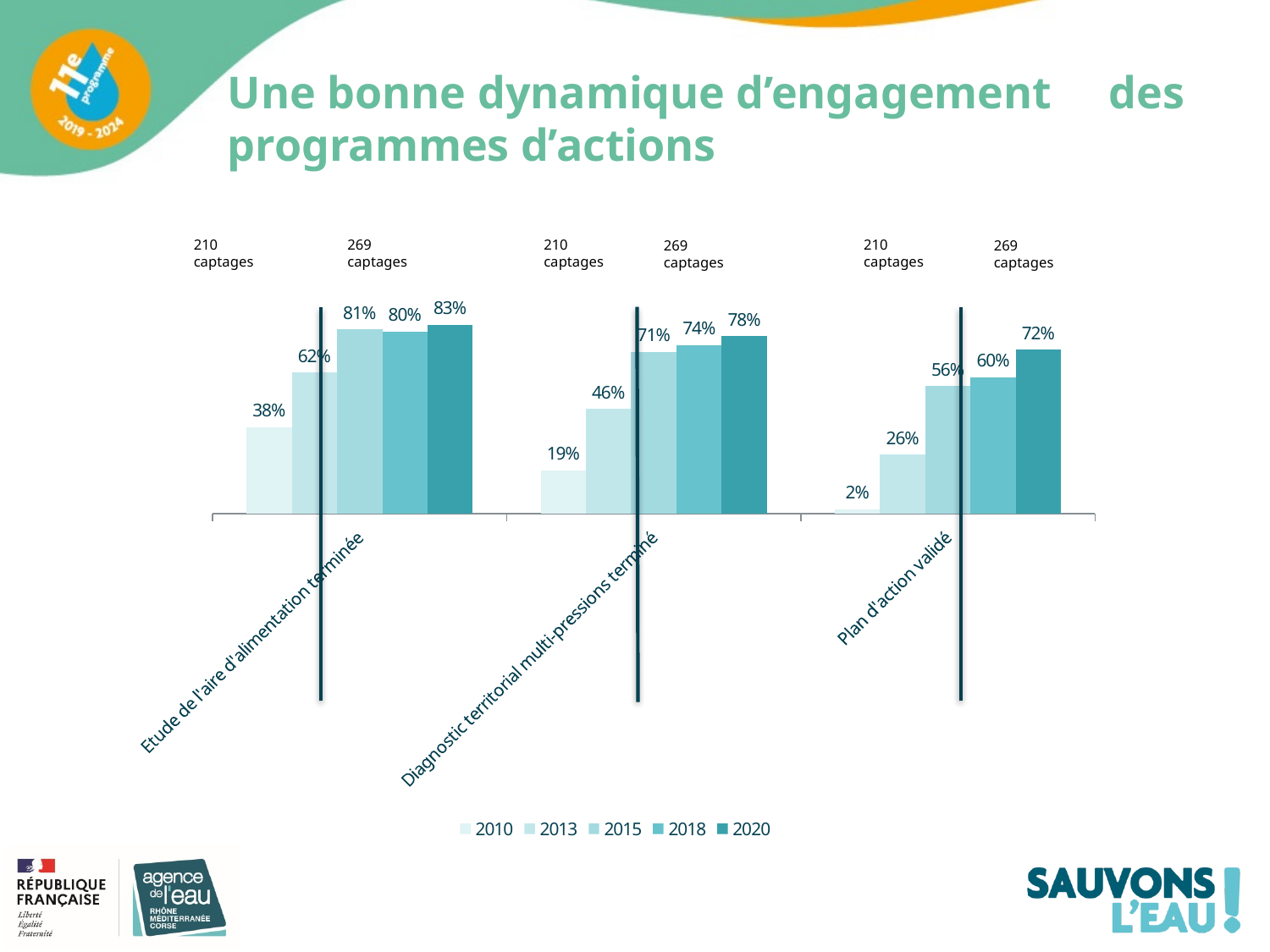
What is the value for 2020 in the category "Plan d'action validé"? 72% Do the values for "Diagnostic territorial multi-pressions terminé" rise or fall from 2010 to 2020? rise Which category has the lowest value for 2010? Plan d'action validé What kind of chart is shown on the slide? bar chart Which year does the darkest bar colour in the legend represent? 2020 What is the value for 2010 in the category "Diagnostic territorial multi-pressions terminé"? 19% What is the value for 2013 in the category "Etude de l'aire d'alimentation terminée"? 62% How many categories are shown on the x axis? 3 Which category has the highest value for 2020? Etude de l'aire d'alimentation terminée Which is larger for "Diagnostic territorial multi-pressions terminé": the 2015 value or the 2018 value? 2018 How many series does the legend list? 5 What is the difference between the 2020 and 2010 values for "Plan d'action validé"? 70%